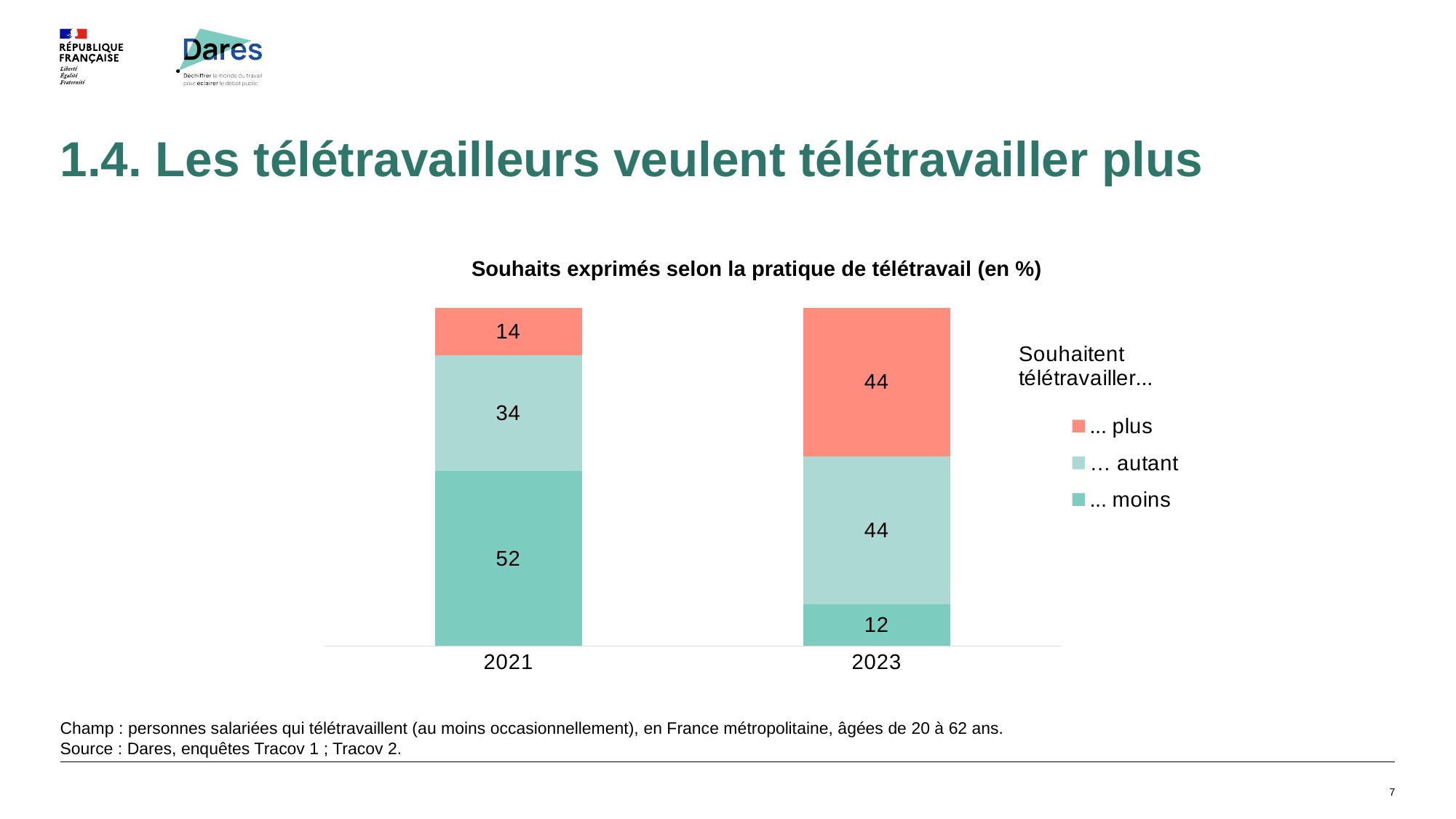
What is the total of the stacked bar for 2021? 100 What is the value for "... plus" in 2021? 14 What is the value for "… autant" in 2021? 34 What is the difference between the "... plus" values for 2023 and 2021? 30 What is the value for "... moins" in 2023? 12 How many series does the legend list? 3 What kind of chart is shown? Stacked bar chart What is the title of the chart? Souhaits exprimés selon la pratique de télétravail (en %) How many categories are shown on the x axis? 2 Does the value for "... moins" rise or fall from 2021 to 2023? Fall Which year has the higher value for "... moins"? 2021 What is the value for "... plus" in 2023? 44